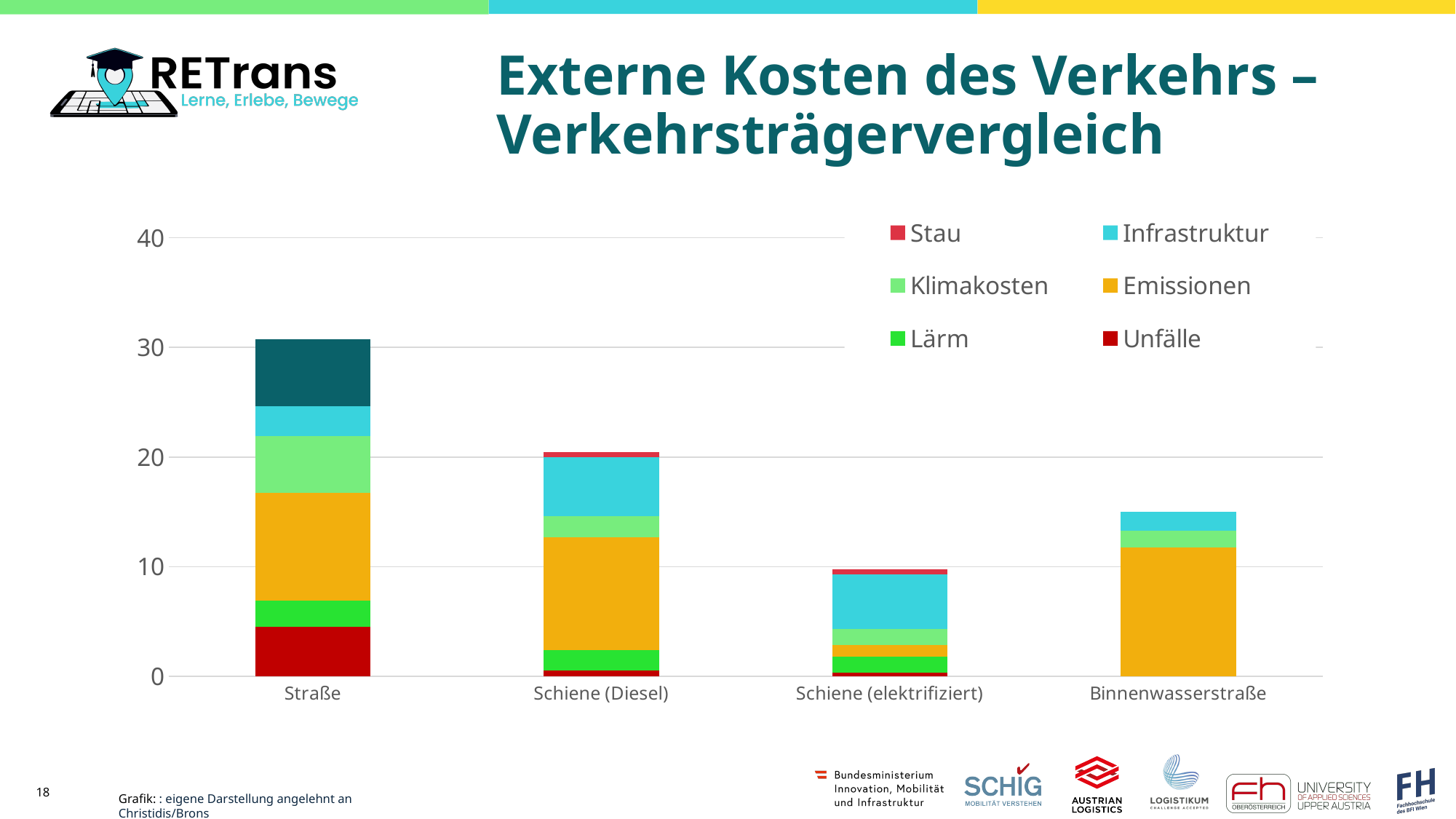
Is the total value for Schiene (elektrifiziert) greater or less than 20? less Is the total value for Straße greater or less than 20? greater How many categories are shown on the x axis of the chart? 4 Which series in the legend is shown in orange? Emissionen What is the title of the slide containing the chart? Externe Kosten des Verkehrs – Verkehrsträgervergleich How many series does the chart's legend list? 6 Which has the larger total bar, Schiene (Diesel) or Binnenwasserstraße? Schiene (Diesel) What kind of chart is shown on the slide? Stacked bar chart Which category has the highest total bar in the chart? Straße Which category has the lowest total bar in the chart? Schiene (elektrifiziert) Is the total value for Binnenwasserstraße greater or less than 20? less